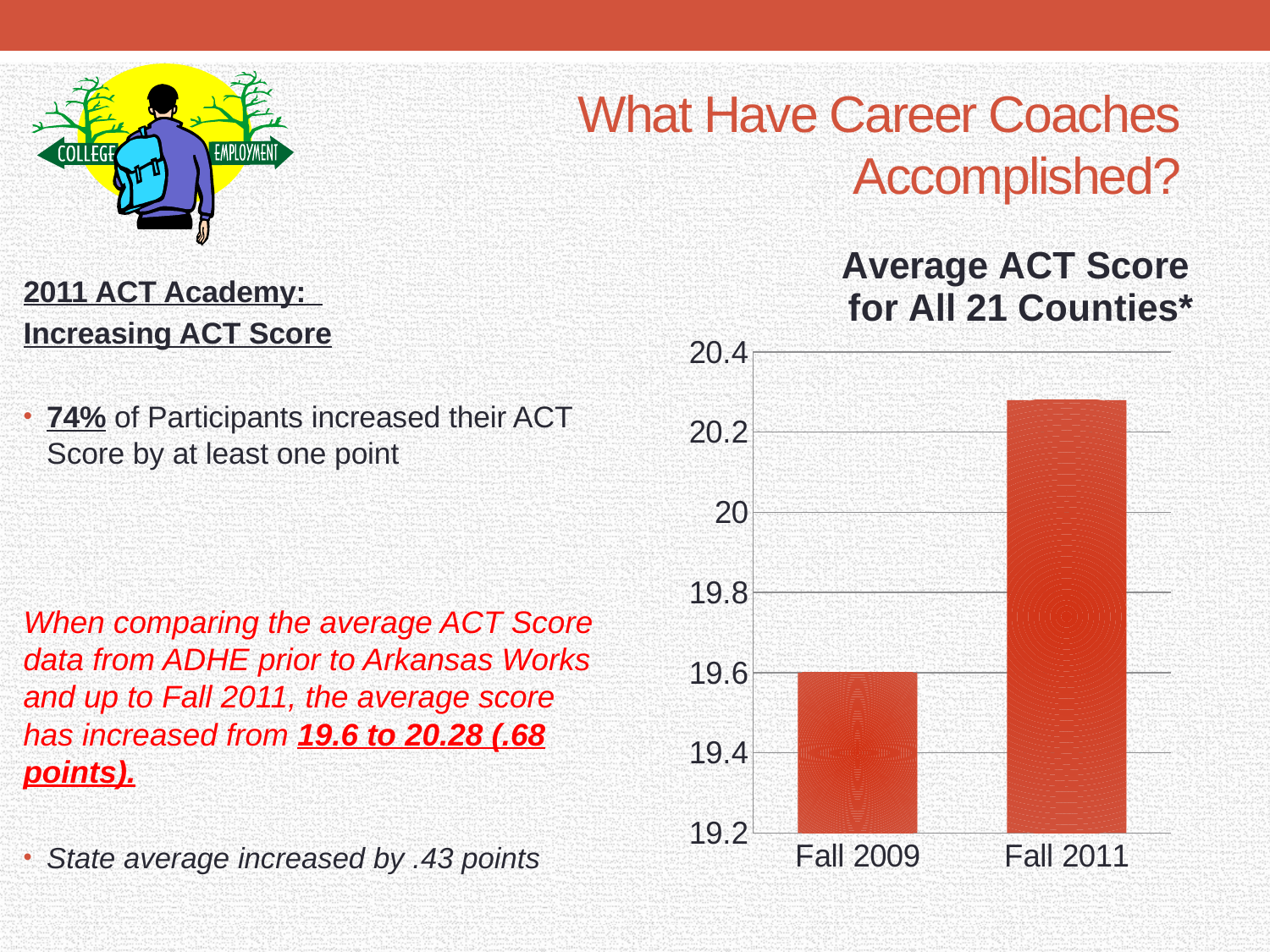
What kind of chart is shown on the slide? bar chart What colour are the bars in the chart? red Is the value for Fall 2009 greater or less than 20? less How many categories are plotted in the chart? 2 Which category has the highest average ACT score in the chart? Fall 2011 What is the title of the chart? Average ACT Score for All 21 Counties* What is the average ACT score shown for Fall 2009? 19.6 Is the value for Fall 2011 greater or less than 20.2? greater Do the values rise or fall from Fall 2009 to Fall 2011? rise Is the value for Fall 2011 greater or less than 20.4? less Which category has the lowest average ACT score in the chart? Fall 2009 Which is larger in the chart, the value for Fall 2009 or Fall 2011? Fall 2011